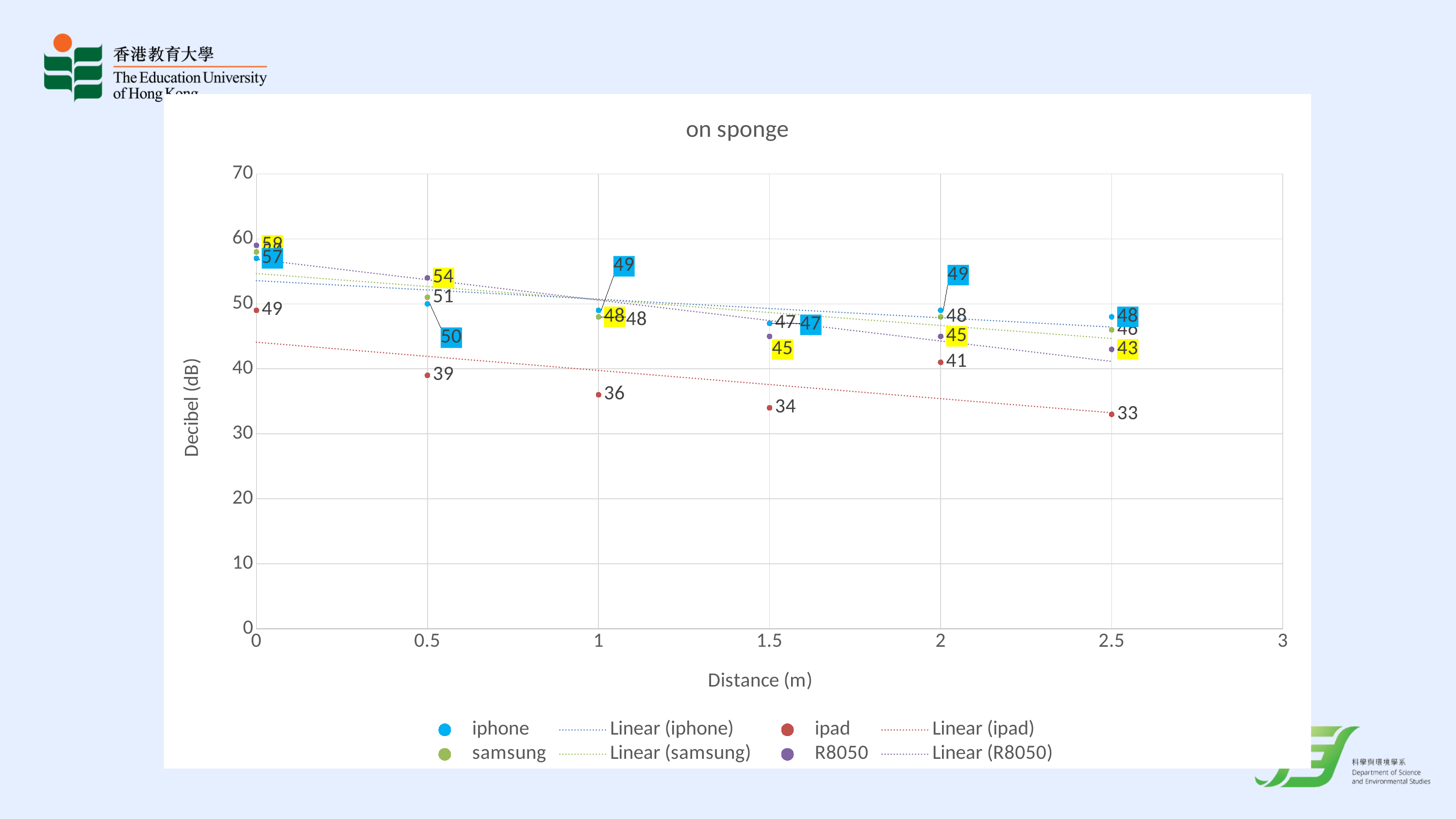
What kind of chart is shown on the slide? scatter chart At a distance of 0.5 m, which is larger, the iphone value or the ipad value? iphone What is the R8050 value at a distance of 0.5 m? 54 What is the ipad value at a distance of 2.5 m? 33 What is the ipad value at a distance of 1 m? 36 What is the samsung value at a distance of 2.5 m? 46 What is the iphone value at a distance of 0 m? 57 At which distance is the ipad value lowest? 2.5 m Do the ipad values generally rise or fall as distance increases? fall What is the title of the chart? on sponge How many entries does the legend list? 8 What is the difference between the ipad value at 0 m and at 2.5 m? 16